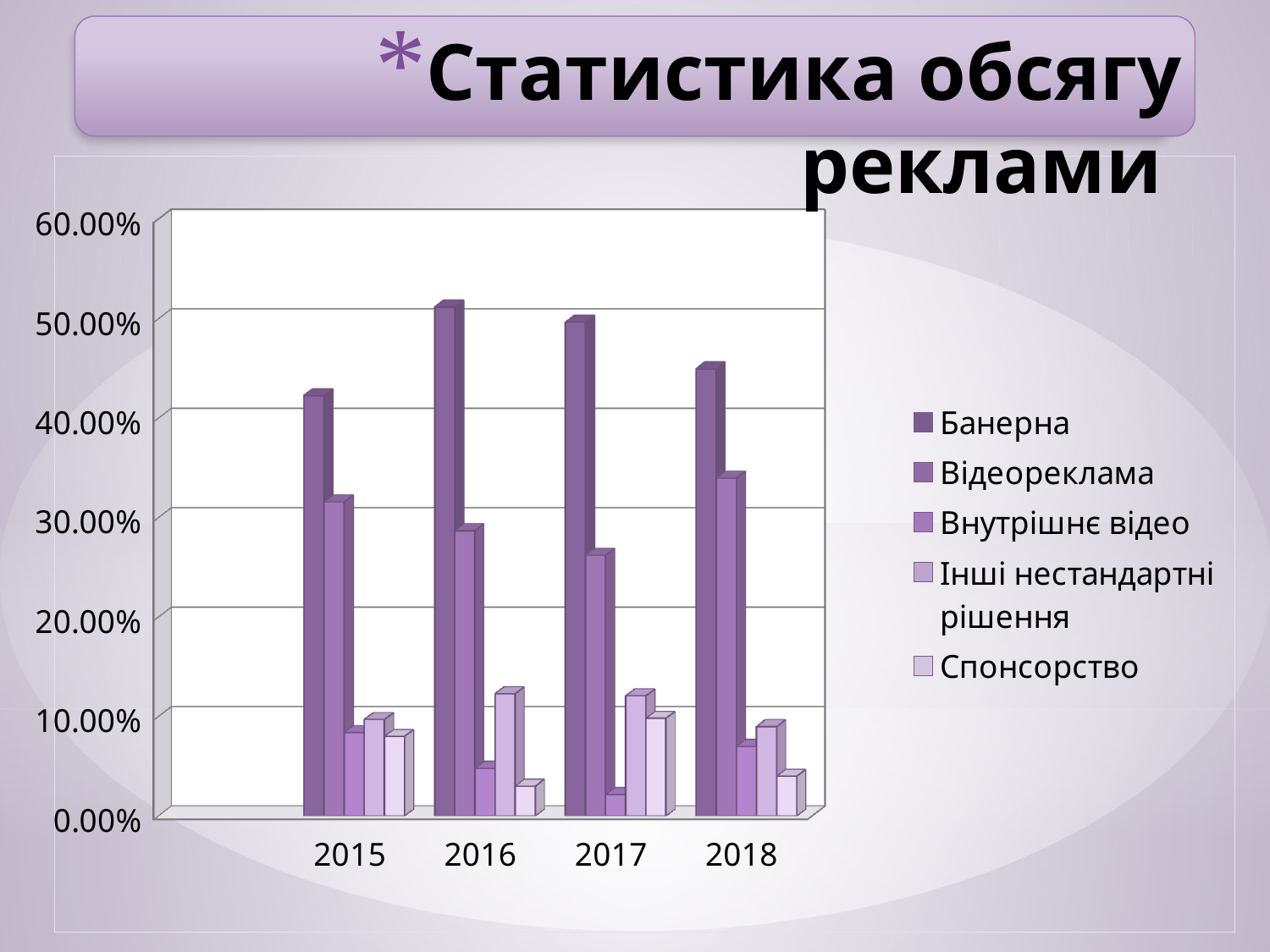
What kind of chart is shown on the slide? bar chart Which series has the lowest value in 2017? Внутрішнє відео Is the value for Внутрішнє відео in 2017 greater or less than 10.00%? less What is the title of the slide containing the chart? Статистика обсягу реклами How many years are shown on the x axis of the chart? 4 Is the value for Банерна in 2015 greater or less than 40.00%? greater Which series is listed last in the chart's legend? Спонсорство How many series does the chart's legend list? 5 Which is larger for Відеореклама: the value in 2015 or the value in 2016? 2015 Is the value for Відеореклама in 2018 greater or less than 30.00%? greater Which series has the highest value in 2015? Банерна Does the value for Внутрішнє відео rise or fall from 2015 to 2017? fall